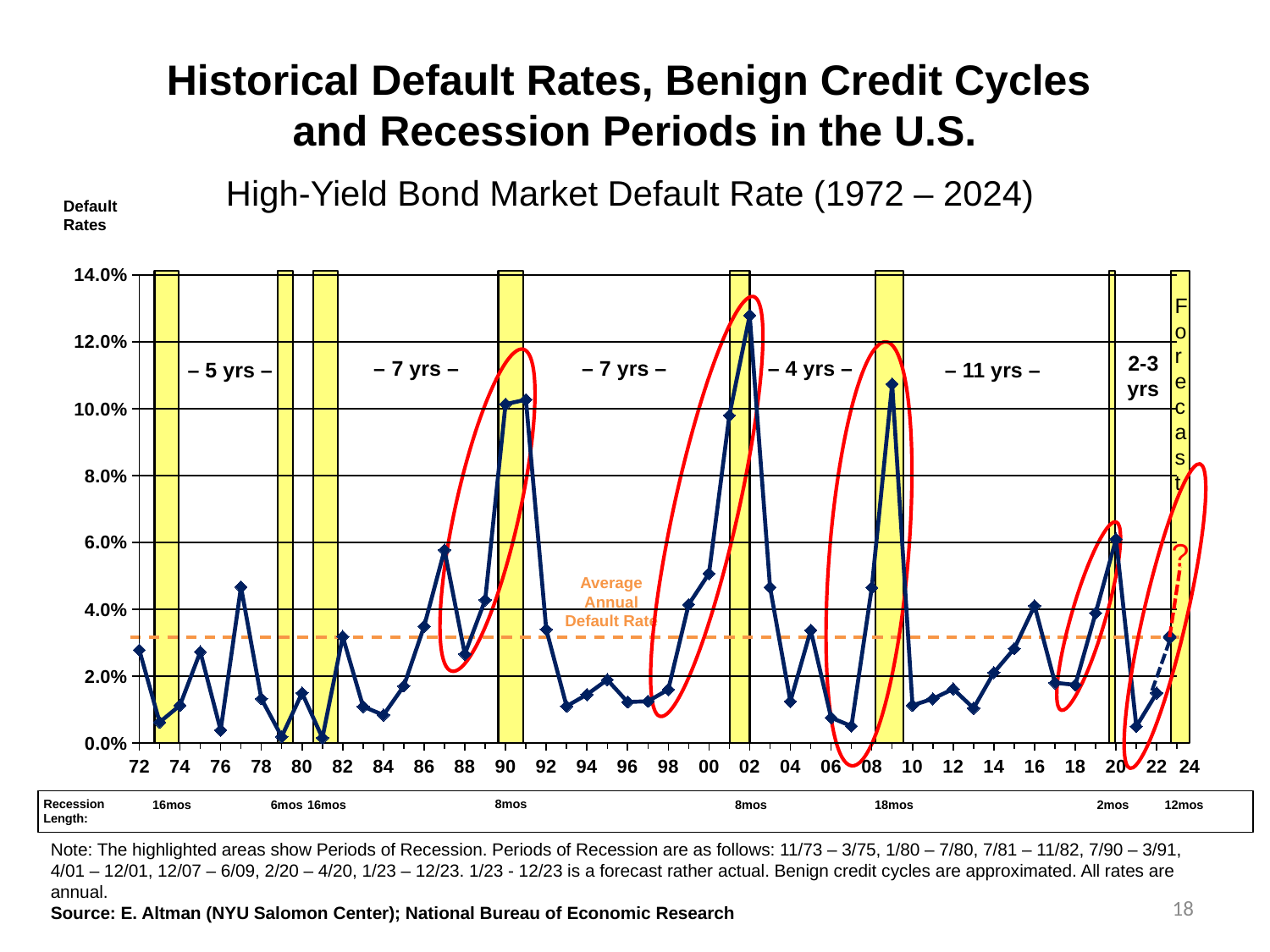
Which year has the higher default rate, 02 or 09? 02 What does the orange dashed horizontal line on the chart represent? Average Annual Default Rate Is the default rate for 87 greater or less than 4.0%? greater What kind of chart is shown on the slide? line chart Is the default rate for 16 greater or less than 2.0%? greater Which year has the higher default rate, 20 or 21? 20 What is the title of the chart? High-Yield Bond Market Default Rate (1972 – 2024) Is the default rate for 21 greater or less than 2.0%? less In which year on the x axis does the high-yield bond default rate reach its highest point? 02